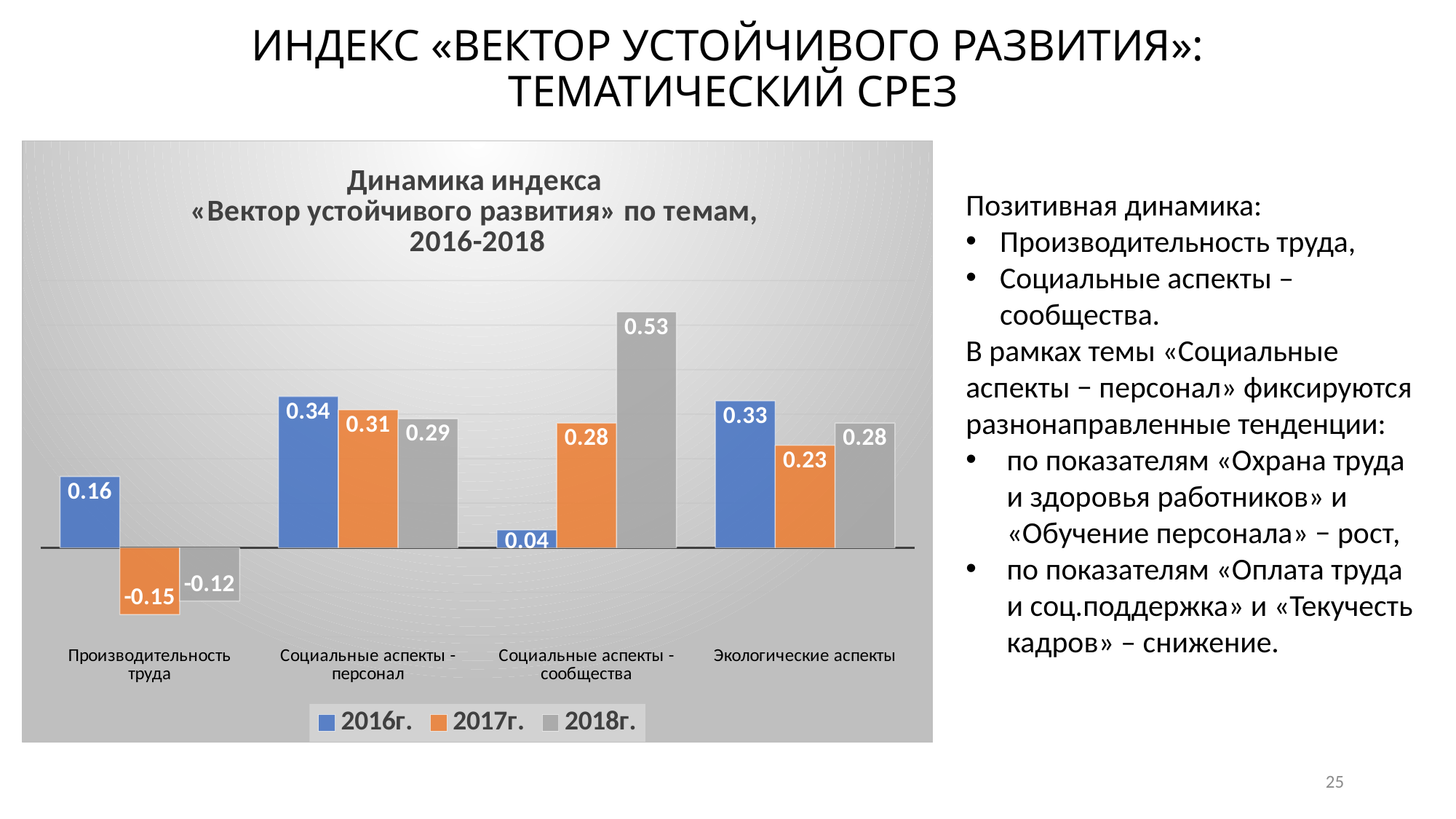
Do the values for the category «Социальные аспекты - персонал» rise or fall from 2016г. to 2018г.? Fall What is the difference between the 2018г. and 2016г. values in the category «Социальные аспекты - сообщества»? 0.49 What kind of chart is shown on the slide? Bar chart Which category has the highest value for the 2018г. series? Социальные аспекты - сообщества How many series does the chart legend list? 3 What is the value for 2017г. in the category «Экологические аспекты»? 0.23 Which is larger in the category «Экологические аспекты»: the 2016г. value or the 2018г. value? 2016г. What is the value for 2017г. in the category «Производительность труда»? -0.15 What is the value for 2016г. in the category «Производительность труда»? 0.16 What is the value for 2018г. in the category «Социальные аспекты - сообщества»? 0.53 How many categories are shown on the x axis of the chart? 4 Which category has the lowest value for the 2016г. series? Социальные аспекты - сообщества